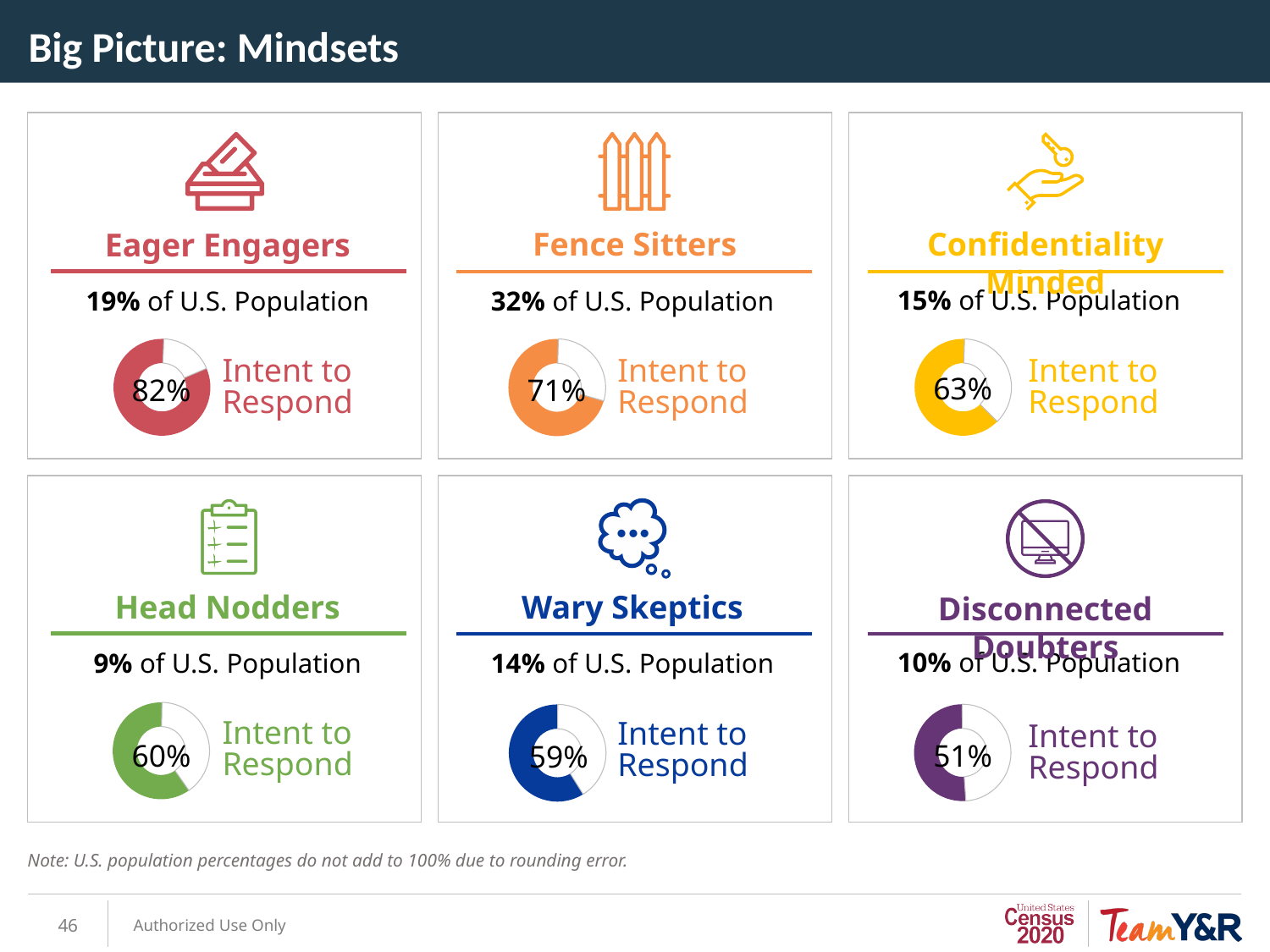
In the Eager Engagers donut chart, what is the Intent to Respond value? 82% Which is larger: the Intent to Respond in the Confidentiality Minded chart or in the Wary Skeptics chart? Confidentiality Minded In the Disconnected Doubters donut chart, what is the Intent to Respond value? 51% Across the six donut charts on the slide, which mindset has the lowest Intent to Respond? Disconnected Doubters What type of chart is used to show Intent to Respond for each mindset? Donut (pie) chart How many donut charts are shown on the slide? 6 In the Fence Sitters donut chart, what is the Intent to Respond value? 71% What is the difference between the Intent to Respond values in the Eager Engagers chart and the Fence Sitters chart? 11% In the Confidentiality Minded donut chart, what is the Intent to Respond value? 63% What colour is the Wary Skeptics donut chart? Dark blue Across the six donut charts on the slide, which mindset has the highest Intent to Respond? Eager Engagers What is the difference between the Intent to Respond values in the Head Nodders chart and the Disconnected Doubters chart? 9%